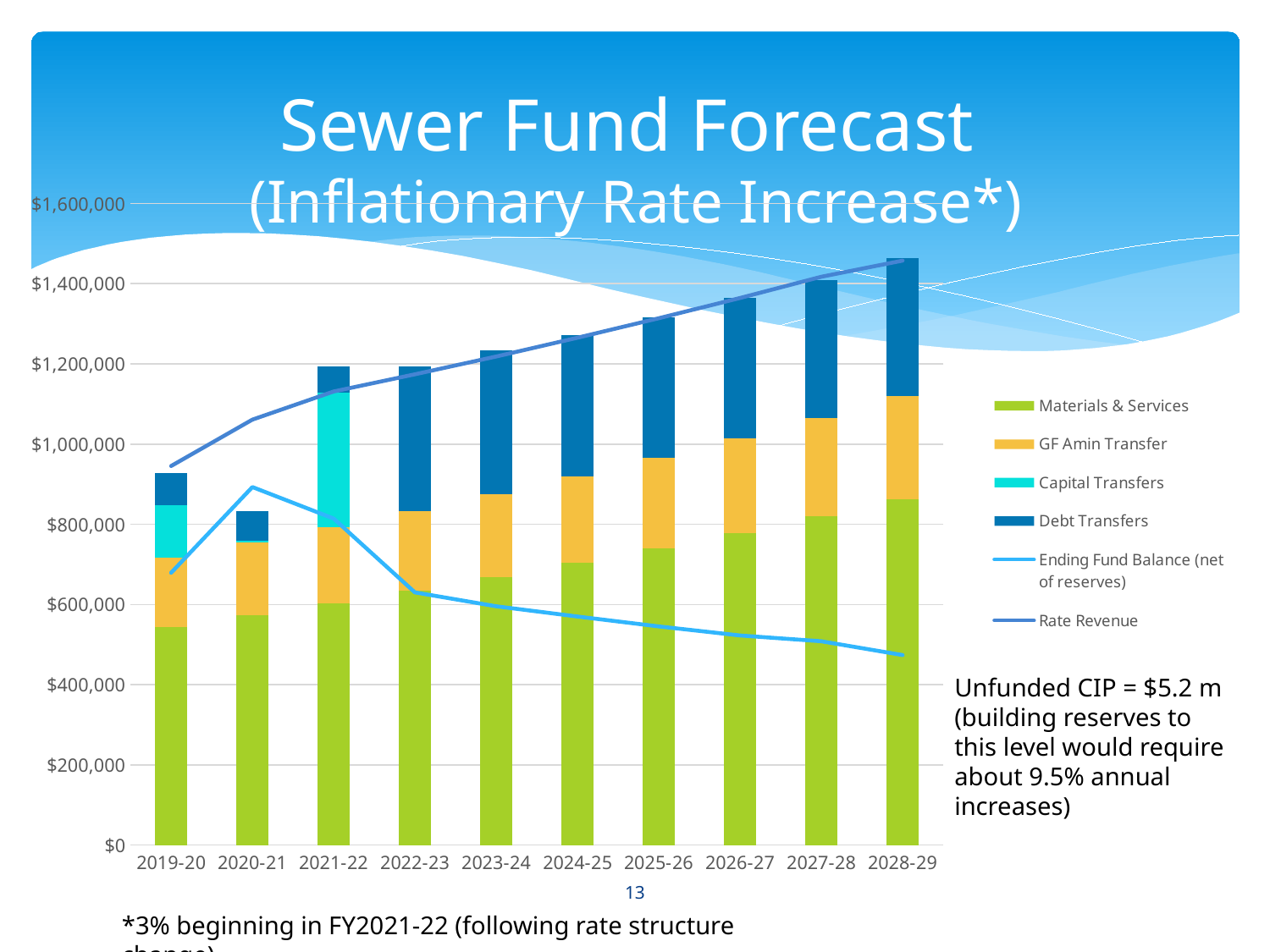
How many series does the legend list? 6 Is the Materials & Services value for 2028-29 larger than the Materials & Services value for 2019-20? Yes, 2028-29 is larger Does the Rate Revenue line rise or fall from 2019-20 to 2028-29? Rise Which fiscal year has the shortest stacked bar? 2020-21 Is the Ending Fund Balance (net of reserves) value for 2028-29 greater or less than $600,000? less What kind of chart is shown on the slide? A stacked bar chart with line series Is the total of the stacked bar for 2020-21 greater or less than $1,000,000? less Does the Ending Fund Balance (net of reserves) line rise or fall from 2020-21 to 2028-29? Fall Is the Rate Revenue value for 2028-29 greater or less than $1,400,000? greater How many fiscal years are shown along the x axis? 10 Which fiscal year has the tallest stacked bar? 2028-29 In how many fiscal years does the Capital Transfers segment appear in the stacked bars? 3